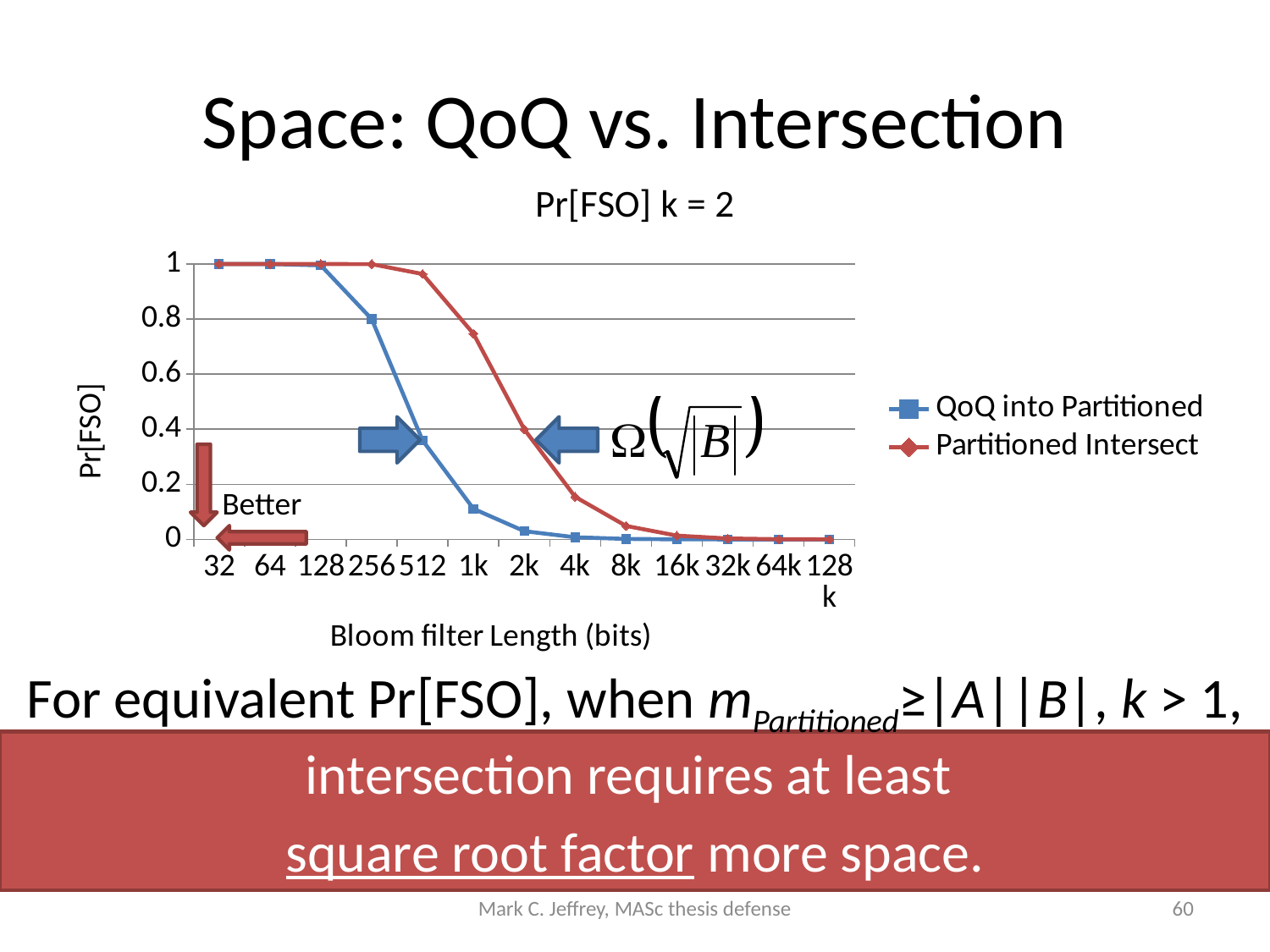
How many Bloom filter length categories are shown on the x axis? 13 What is the x-axis title of the chart? Bloom filter Length (bits) Is the Pr[FSO] value for Partitioned Intersect at 512 greater or less than 0.8? greater At a Bloom filter length of 512, which series has the higher Pr[FSO], QoQ into Partitioned or Partitioned Intersect? Partitioned Intersect Is the Pr[FSO] value for QoQ into Partitioned at 1k greater or less than 0.2? less Do the Pr[FSO] values rise or fall as the Bloom filter length increases? fall At a Bloom filter length of 1k, which series has the higher Pr[FSO], QoQ into Partitioned or Partitioned Intersect? Partitioned Intersect Is the Pr[FSO] value for Partitioned Intersect at 1k greater or less than 0.6? greater What is the title of the chart? Pr[FSO] k = 2 What kind of chart is shown on the slide? line chart How many series does the chart legend list? 2 What is the Pr[FSO] value for QoQ into Partitioned at a Bloom filter length of 32? 1